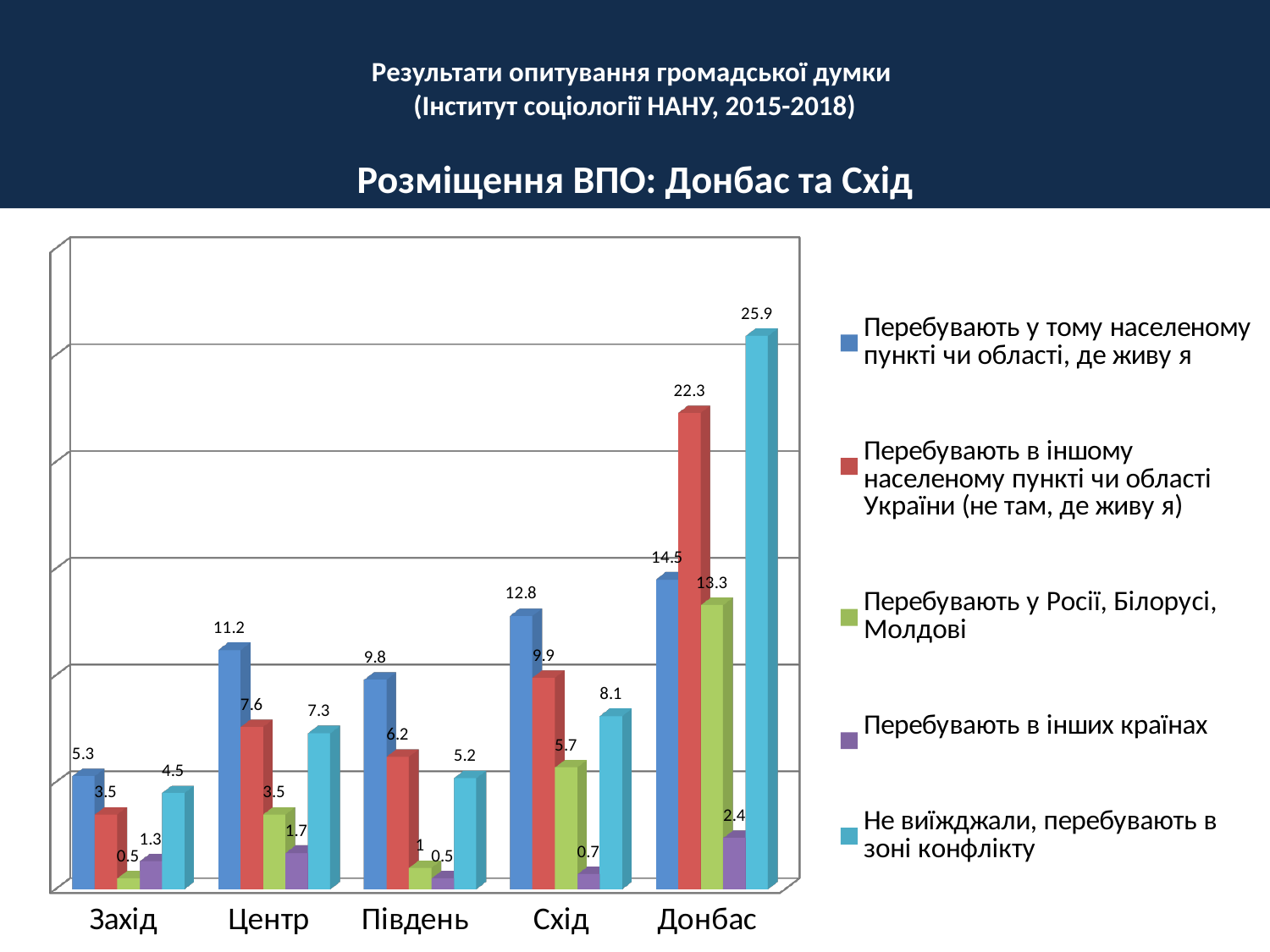
What is the value for Центр in the series "Перебувають у тому населеному пункті чи області, де живу я"? 11.2 What is the title of the chart on the slide? Розміщення ВПО: Донбас та Схід Which region has the lowest value in the series "Перебувають у тому населеному пункті чи області, де живу я"? Захід What is the difference between the Донбас values for "Не виїжджали, перебувають в зоні конфлікту" and "Перебувають в іншому населеному пункті чи області України (не там, де живу я)"? 3.6 What is the value for Схід in the series "Перебувають у Росії, Білорусі, Молдові"? 5.7 How many series does the legend list? 5 Which region has the highest value in the series "Перебувають в іншому населеному пункті чи області України (не там, де живу я)"? Донбас Which is larger for Схід: "Перебувають у тому населеному пункті чи області, де живу я" or "Перебувають в іншому населеному пункті чи області України (не там, де живу я)"? Перебувають у тому населеному пункті чи області, де живу я How many regions are shown on the x axis of the chart? 5 What kind of chart is shown on the slide? Bar chart What is the value for Південь in the series "Перебувають в інших країнах"? 0.5 What is the value for Донбас in the series "Не виїжджали, перебувають в зоні конфлікту"? 25.9